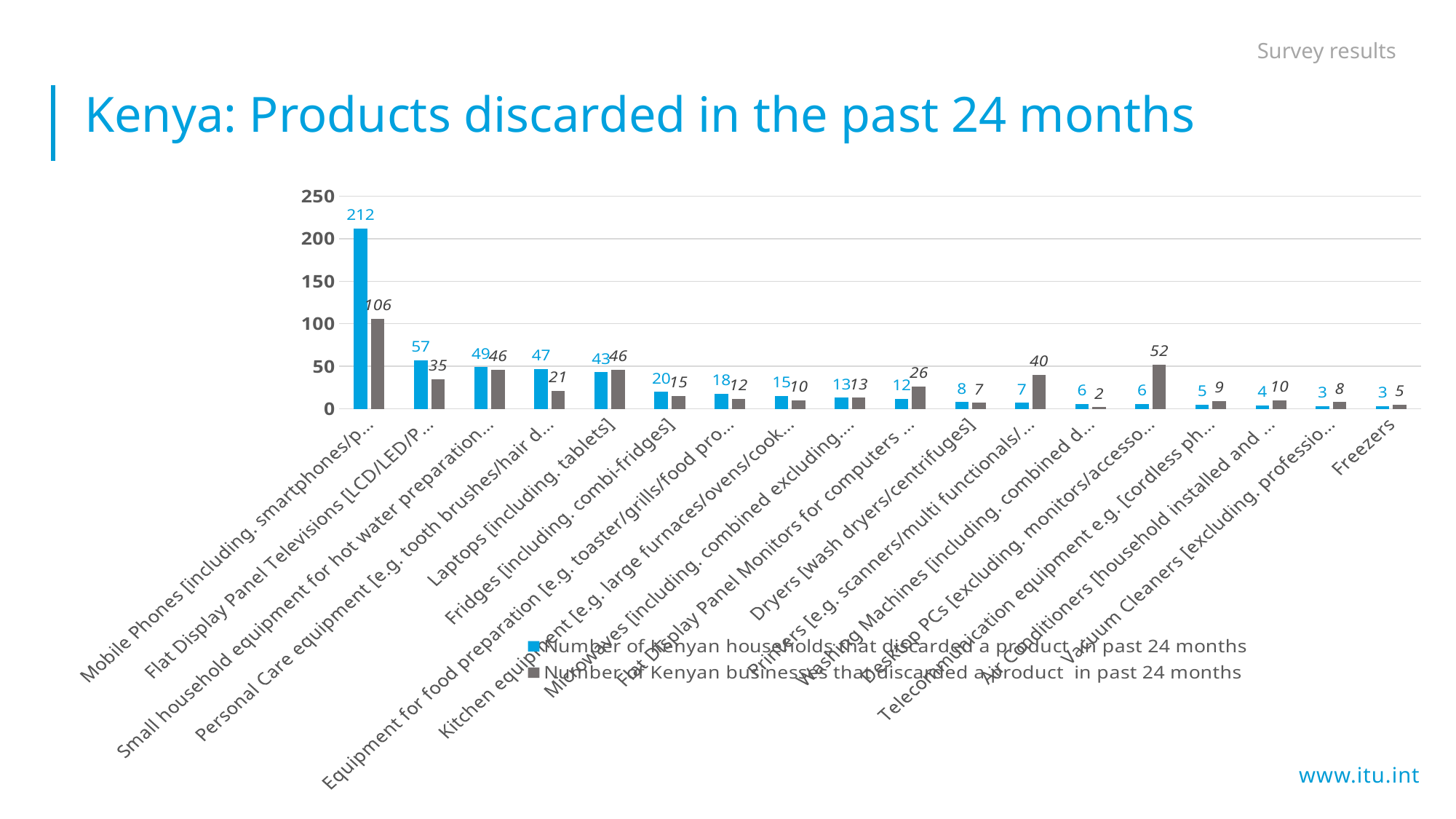
For Printers, which is larger: the households value or the businesses value? businesses What is the difference between the household and business values for Mobile Phones? 106 What is the number of Kenyan businesses that discarded Laptops in the past 24 months? 46 Which product category has the lowest value for Kenyan businesses? Washing Machines How many product categories are plotted on the x axis? 18 What is the number of Kenyan households that discarded Freezers in the past 24 months? 3 What is the number of Kenyan businesses that discarded Desktop PCs in the past 24 months? 52 Which product category has the highest value for Kenyan households? Mobile Phones What is the number of Kenyan households that discarded Mobile Phones in the past 24 months? 212 How many series does the legend list? 2 What is the title of the chart? Kenya: Products discarded in the past 24 months What type of chart is shown on the slide? bar chart